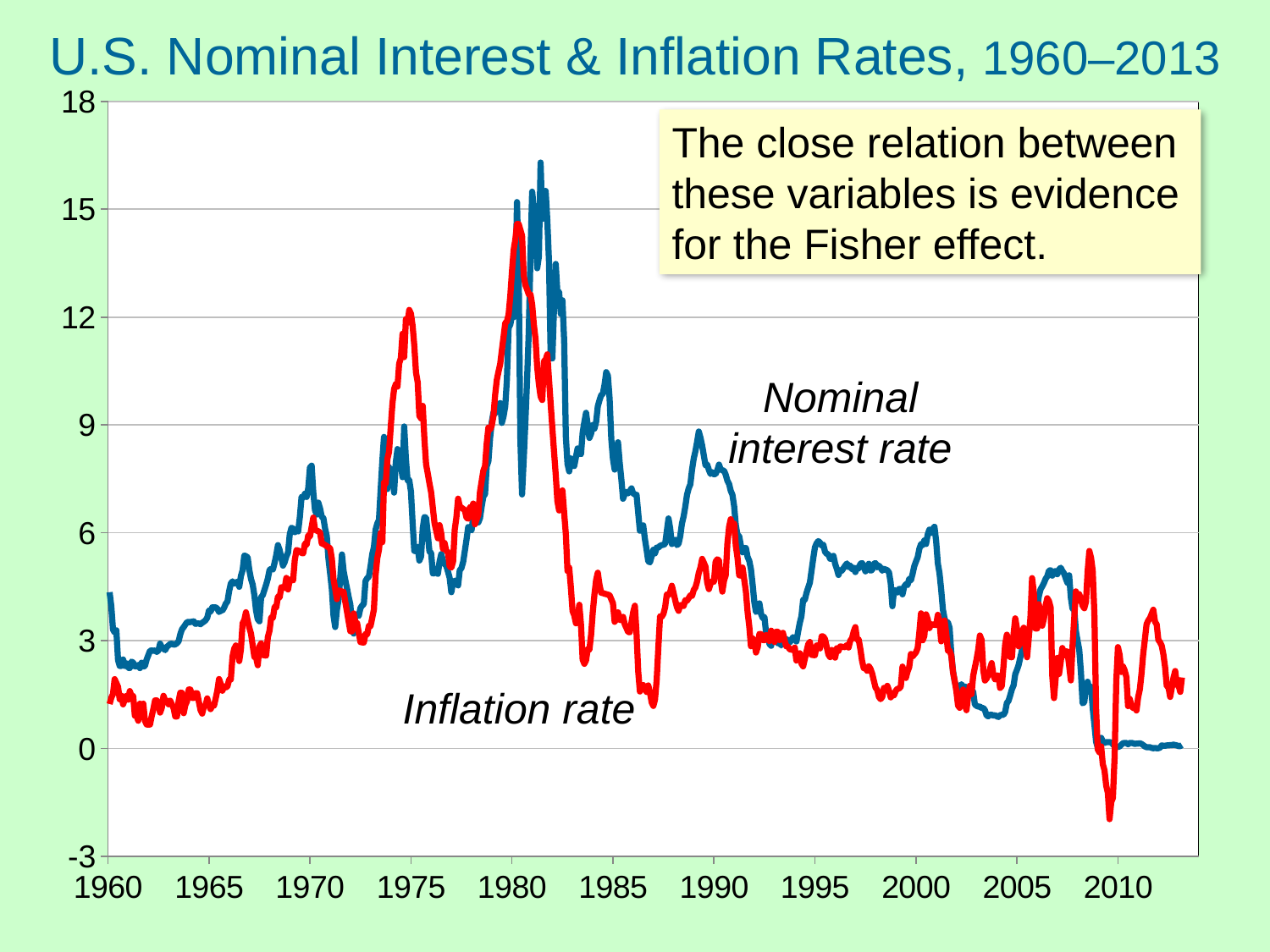
Which series reaches the higher peak value over the whole period? Nominal interest rate How many data series are plotted on the chart? 2 Is the peak value of the inflation rate around 1975 greater or less than 9? greater What kind of chart is shown on the slide? Line chart In 1960, which is higher, the nominal interest rate or the inflation rate? Nominal interest rate Is the lowest value of the inflation rate (around 2009) greater or less than 0? less What colour is the inflation rate line? Red From 1981 to 1986, does the nominal interest rate generally rise or fall? Fall In 2012, which is higher, the nominal interest rate or the inflation rate? Inflation rate Is the peak value of the nominal interest rate around 1981 greater or less than 15? greater What is the title of the chart? U.S. Nominal Interest & Inflation Rates, 1960–2013